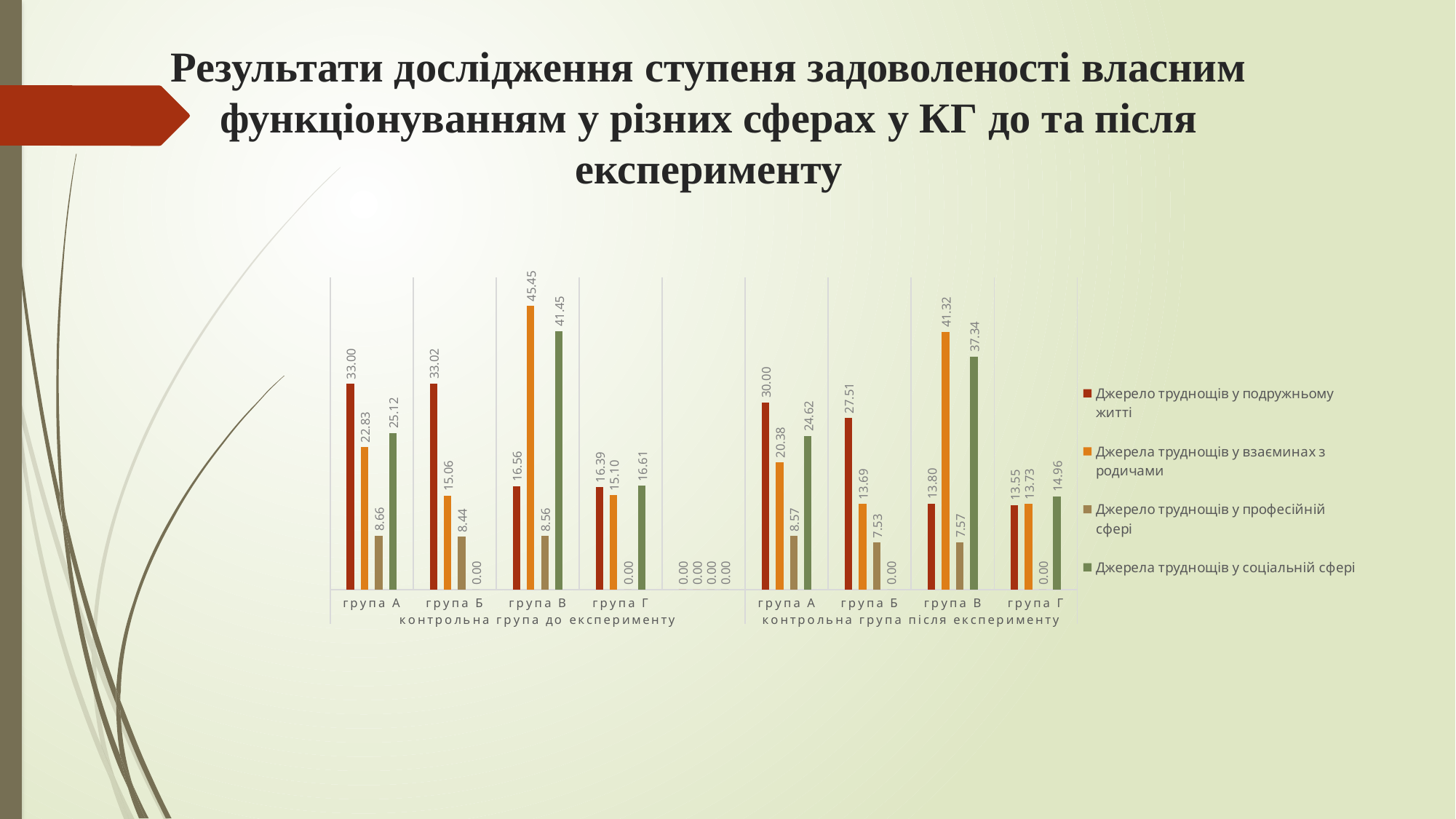
Which is larger: 'Джерело труднощів у подружньому житті' for група Б before the experiment or after the experiment? Before the experiment (33.02) What is the difference between 'Джерело труднощів у подружньому житті' (33.00) and 'Джерела труднощів у взаєминах з родичами' (22.83) for група А before the experiment? 10.17 What is the value for 'Джерела труднощів у взаєминах з родичами' for група В in the 'контрольна група до експерименту' section? 45.45 Which bar has the highest value in the whole chart? Джерела труднощів у взаєминах з родичами, група В (до експерименту) What is the value for 'Джерела труднощів у соціальній сфері' for група В in the 'контрольна група після експерименту' section? 37.34 Which colour represents 'Джерела труднощів у соціальній сфері' in the legend? Green What is the value for 'Джерело труднощів у професійній сфері' for група Б in the 'контрольна група до експерименту' section? 8.44 How many series does the legend list? 4 What is the difference between the 'Джерела труднощів у взаєминах з родичами' value for група В before the experiment (45.45) and after the experiment (41.32)? 4.13 What is the value for 'Джерела труднощів у соціальній сфері' for група Б in the 'контрольна група після експерименту' section? 0.00 What kind of chart is shown on the slide? Bar chart What is the value for 'Джерело труднощів у подружньому житті' for група А in the 'контрольна група після експерименту' section? 30.00